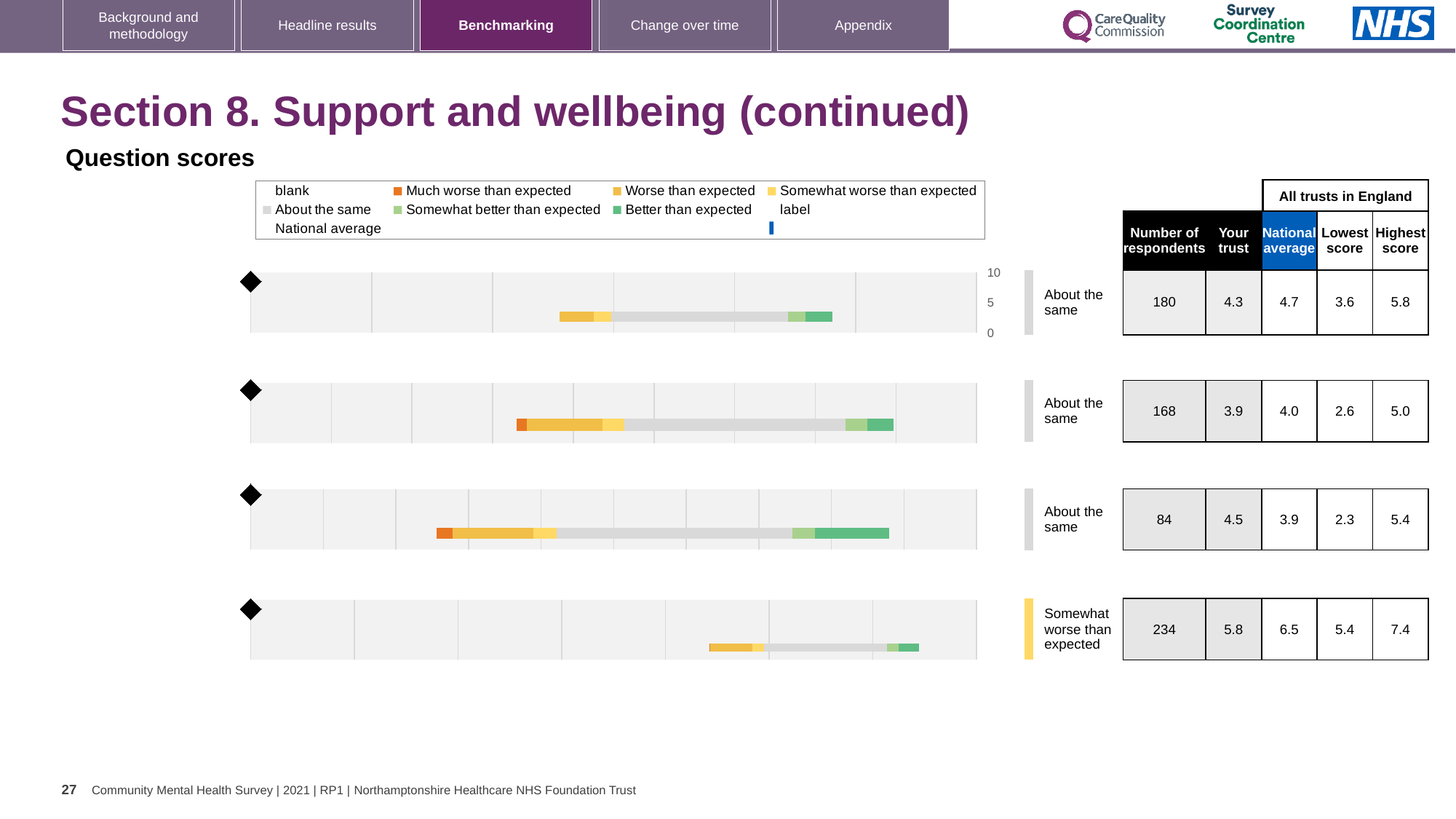
For the bottom (fourth) chart, what is the difference between the highest score and the lowest score in the table? 2.0 For the top (first) chart, what is the number of respondents shown in the table? 180 For the bottom (fourth) chart, what is the 'Your trust' score shown in the table? 5.8 How many of the four charts are rated 'About the same'? 3 How many question score charts are shown on the slide? 4 In the legend, what colour represents 'Better than expected'? green For the third chart, is the 'Your trust' score higher or lower than the national average? higher What benchmark rating is shown next to the top (first) chart? About the same What type of chart is used for the four question score charts on this slide? bar chart How many rating categories does the legend list from 'Much worse than expected' through to 'Better than expected'? 6 What benchmark rating is shown next to the bottom (fourth) chart? Somewhat worse than expected In the legend, what colour represents 'Much worse than expected'? orange